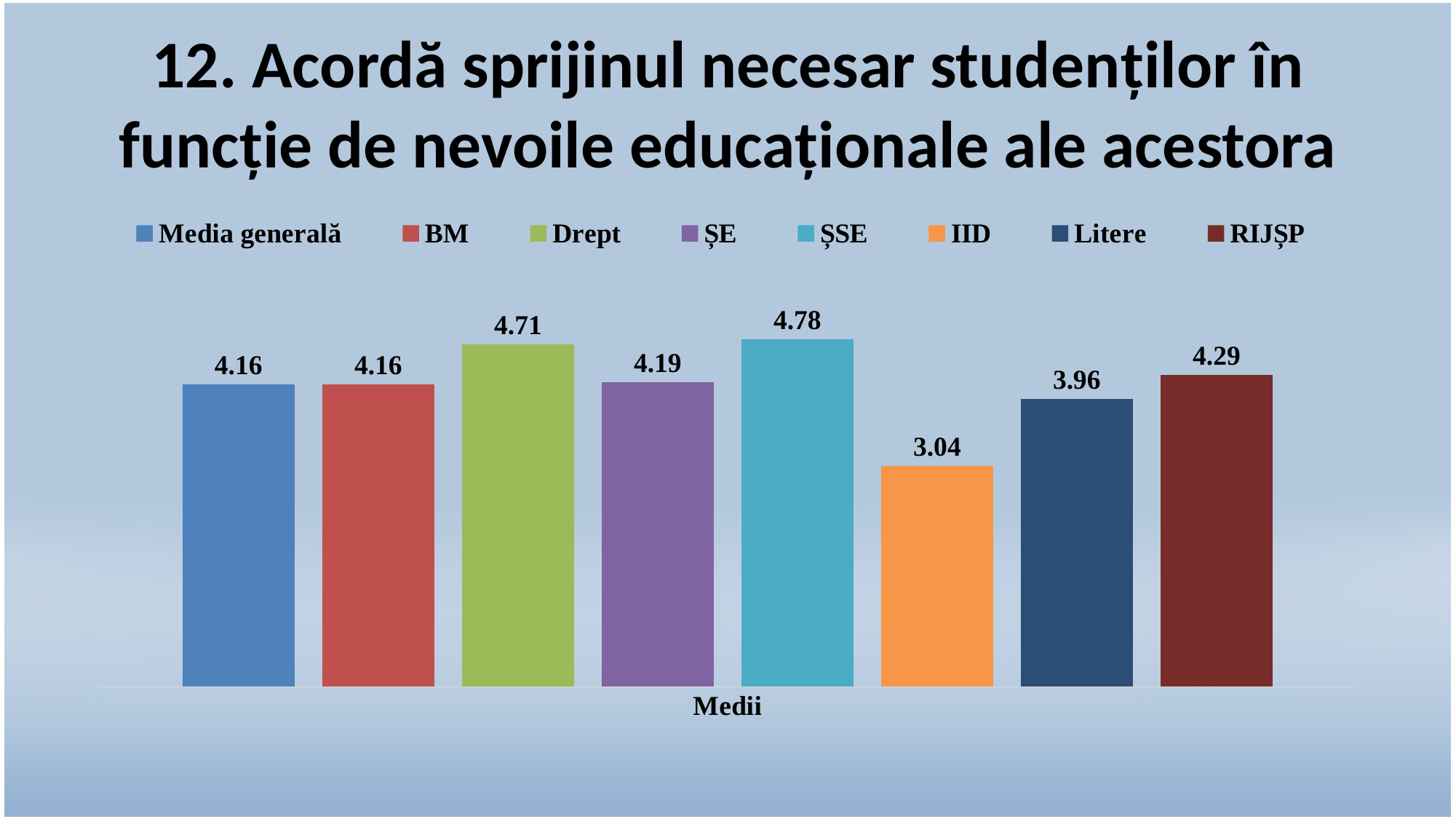
What kind of chart is shown on the slide? Bar chart What is the value for Media generală? 4.16 What is the difference between the values for ȘSE and IID? 1.74 Which series has the lowest value? IID What is the value for IID? 3.04 What is the label on the x axis of the chart? Medii What is the difference between the values for Drept and Litere? 0.75 What is the value for Litere? 3.96 What is the value for ȘSE? 4.78 How many series does the legend list? 8 Which is larger, the value for RIJȘP or the value for ȘE? RIJȘP Which series has the highest value? ȘSE